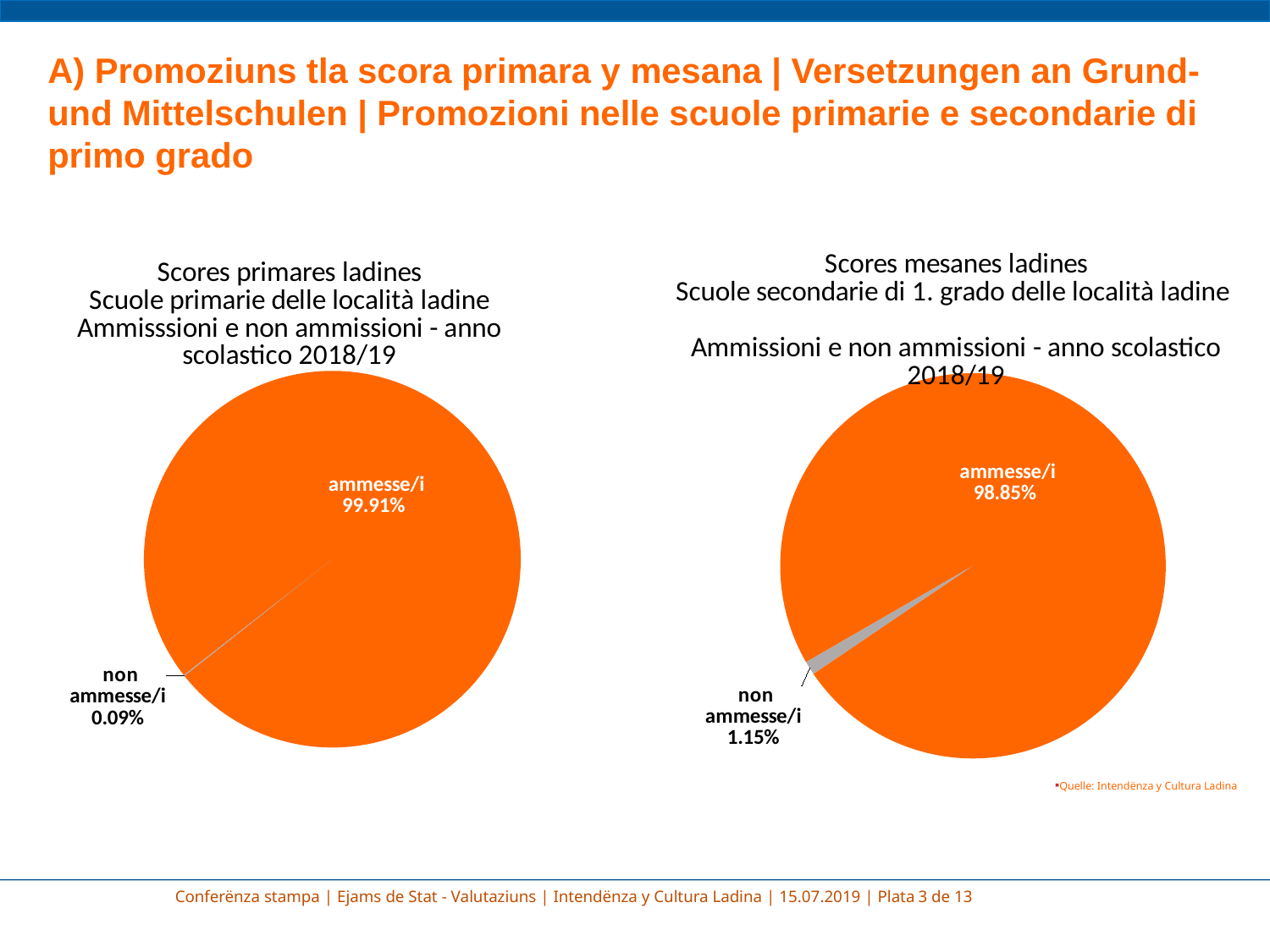
In the right pie chart (Scores mesanes ladines), which slice is the smallest? non ammesse/i What colour is the ammesse/i slice in both pie charts? Orange In the right pie chart (Scores mesanes ladines), what share is labelled for non ammesse/i? 1.15% What is the difference between the non ammesse/i share in the right pie chart and the non ammesse/i share in the left pie chart? 1.06% How many slices does the right pie chart (Scores mesanes ladines) have? 2 In the left pie chart (Scores primares ladines), which slice is the largest? ammesse/i What type of chart is used on the left of the slide? Pie chart In the left pie chart (Scores primares ladines), what share is labelled for non ammesse/i? 0.09% In the right pie chart (Scores mesanes ladines), what share is labelled for ammesse/i? 98.85% Which chart has the larger share of non ammesse/i, the left (Scores primares ladines) or the right (Scores mesanes ladines)? Right (Scores mesanes ladines) Which school year do both pie charts refer to? 2018/19 In the left pie chart (Scores primares ladines), what share is labelled for ammesse/i? 99.91%